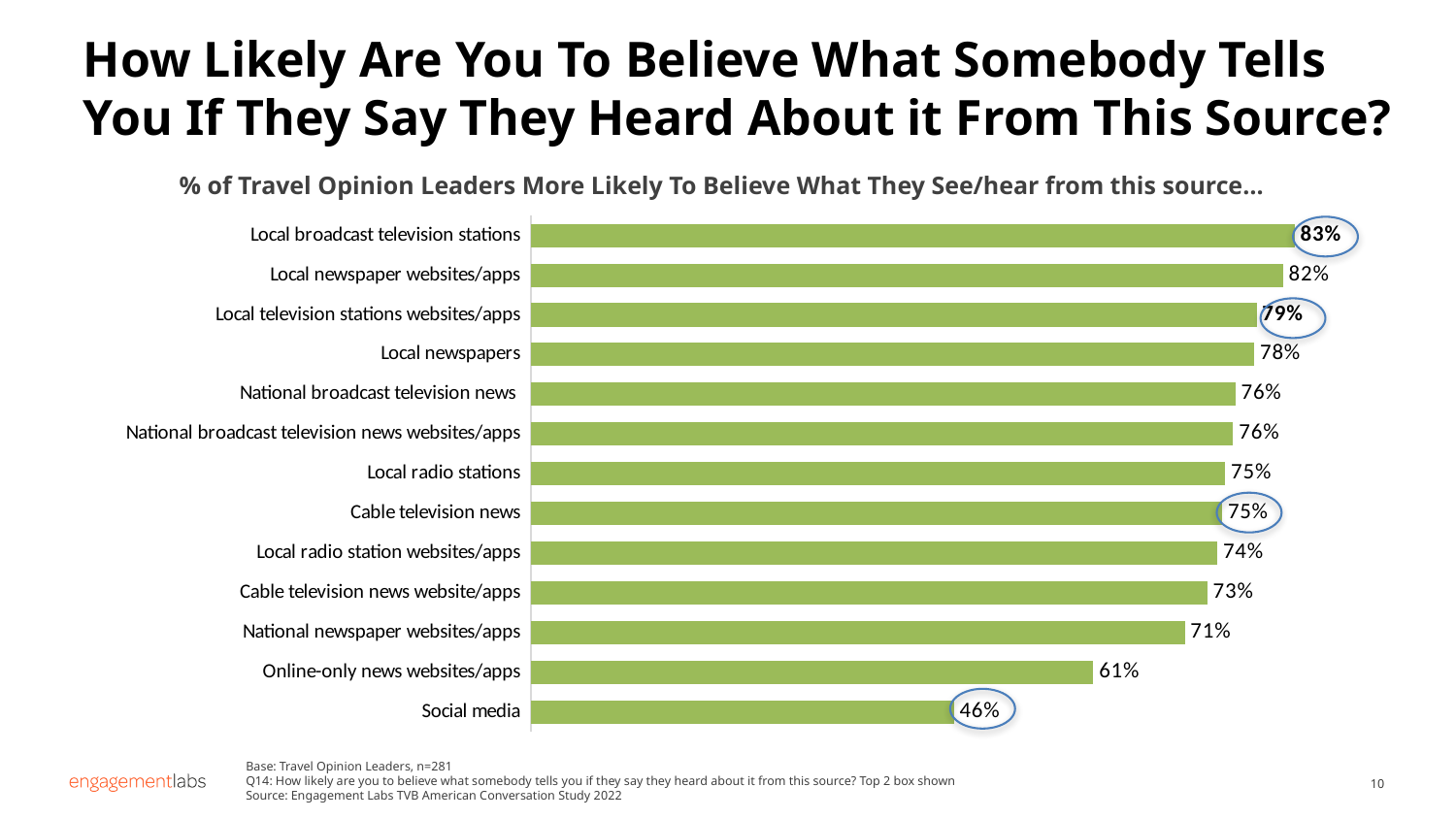
What is the difference between the values for Local broadcast television stations and Social media? 37% Which has a larger value, Local newspaper websites/apps or National newspaper websites/apps? Local newspaper websites/apps What colour are the bars in the chart? Green Which source has the highest percentage? Local broadcast television stations What is the value shown for Social media? 46% Which source has the lowest percentage? Social media What is the difference between the values for Local newspapers and Online-only news websites/apps? 17% How many sources are shown in the chart? 13 What is the value shown for Cable television news? 75% What percentage of Travel Opinion Leaders are more likely to believe what they hear from local broadcast television stations? 83% What is the value shown for Online-only news websites/apps? 61% What kind of chart is shown on the slide? Bar chart